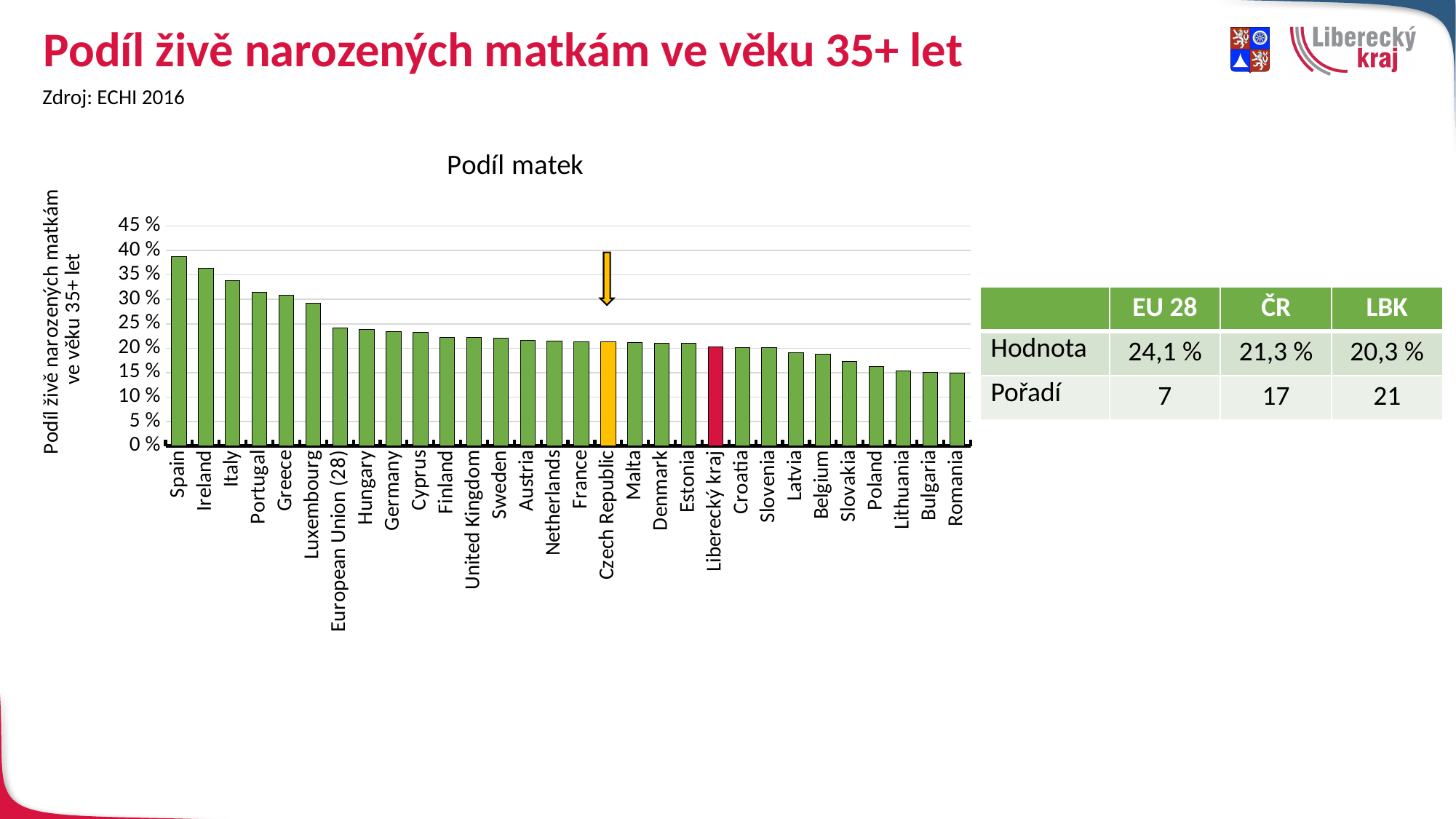
Is the value for Spain greater or less than 35 %? greater What kind of chart is shown on the slide? bar chart Which has the larger value, Hungary or Poland? Hungary According to the table next to the chart, what is the value for the Czech Republic (ČR)? 21,3 % Which has the larger value, Spain or Ireland? Spain Which country has the highest share of live births to mothers aged 35+? Spain What is the title of the chart? Podíl matek Do the bar values rise or fall from left to right along the x axis? fall What colour is the bar for Liberecký kraj? red Is the value for Romania greater or less than 20 %? less How many countries or regions are plotted in the chart? 30 Is the value for Luxembourg greater or less than 25 %? greater